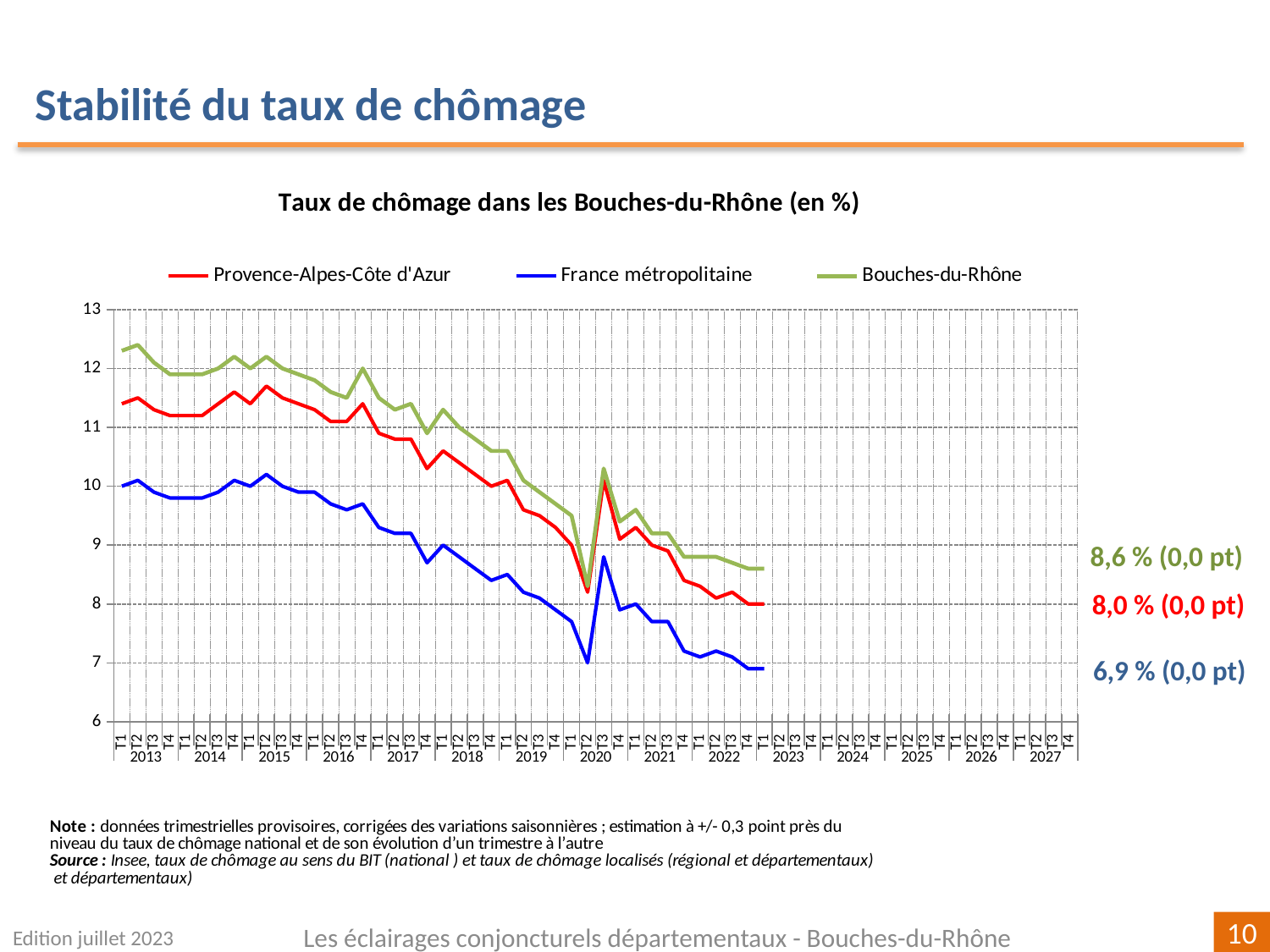
What is the latest value shown for Provence-Alpes-Côte d'Azur? 8,0 % What is the latest value shown for France métropolitaine? 6,9 % Is the value for Bouches-du-Rhône in T1 2013 greater or less than 12? greater Which series has the lowest latest value? France métropolitaine At the latest point, which is higher: Provence-Alpes-Côte d'Azur or France métropolitaine? Provence-Alpes-Côte d'Azur What is the difference between the latest values for Bouches-du-Rhône and France métropolitaine? 1,7 points Which series has the highest latest value? Bouches-du-Rhône Is the value for France métropolitaine in T1 2015 greater or less than 9? greater How many series does the legend list? 3 What kind of chart is shown? line chart What is the latest value shown for Bouches-du-Rhône? 8,6 % Overall, do the unemployment rates rise or fall from 2013 to 2023? fall